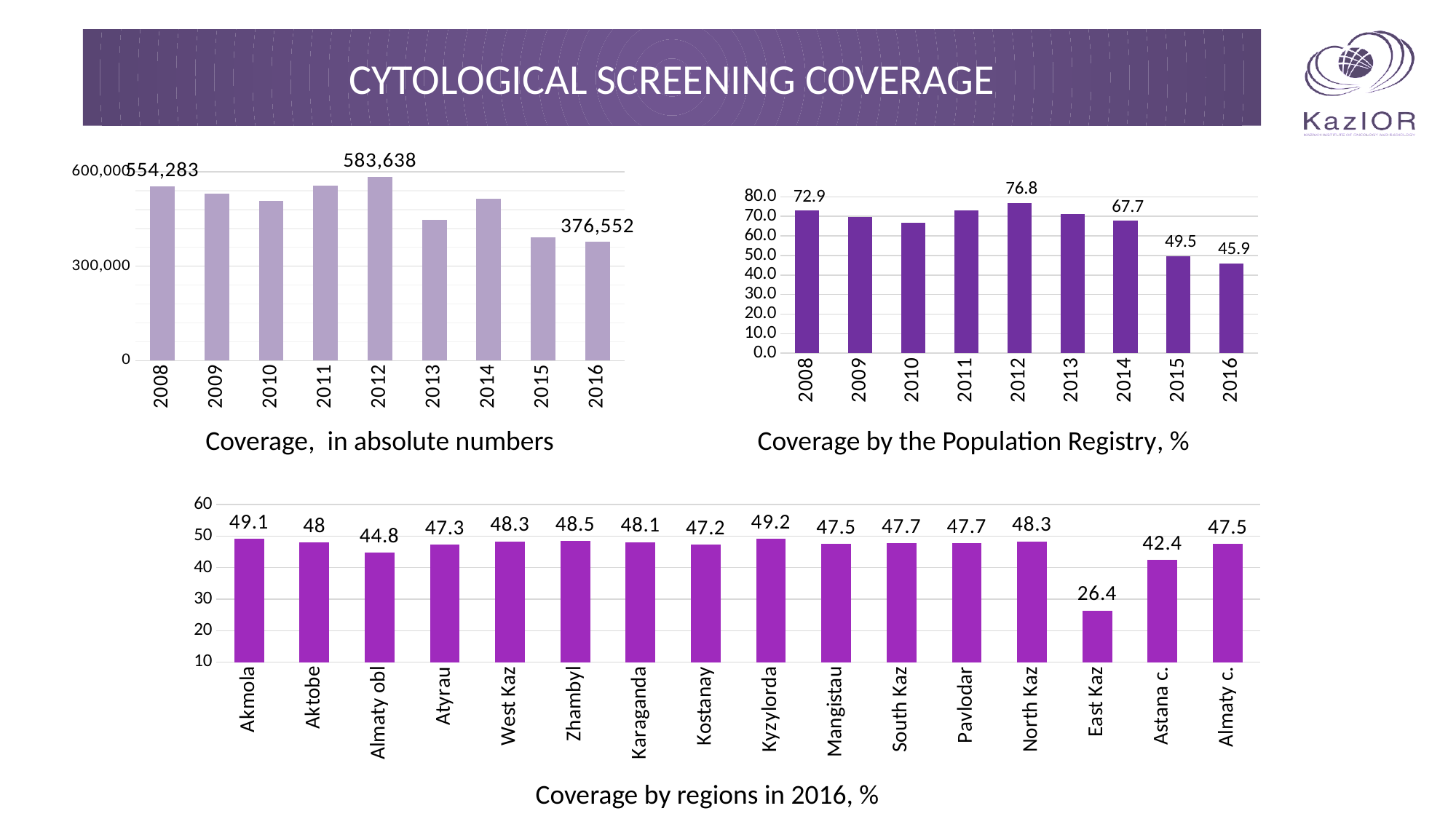
In the chart titled 'Coverage, in absolute numbers', what is the value for 2012? 583,638 In the chart titled 'Coverage, in absolute numbers', what is the value for 2016? 376,552 In the chart titled 'Coverage by regions in 2016, %', how many regions are shown? 16 In the chart titled 'Coverage by the Population Registry, %', what is the difference between the 2015 and 2016 values? 3.6 In the chart titled 'Coverage, in absolute numbers', how many years are shown on the x axis? 9 In the chart titled 'Coverage by regions in 2016, %', which region has the lowest value? East Kaz In the chart titled 'Coverage by the Population Registry, %', which year has the highest value? 2012 In the chart titled 'Coverage by the Population Registry, %', what is the value for 2012? 76.8 In the chart titled 'Coverage by the Population Registry, %', which year has the lowest value? 2016 In the chart titled 'Coverage by the Population Registry, %', is the value for 2010 greater or less than 70.0? less In the chart titled 'Coverage, in absolute numbers', what is the difference between the 2012 and 2016 values? 207,086 In the chart titled 'Coverage by regions in 2016, %', what is the value for East Kaz? 26.4